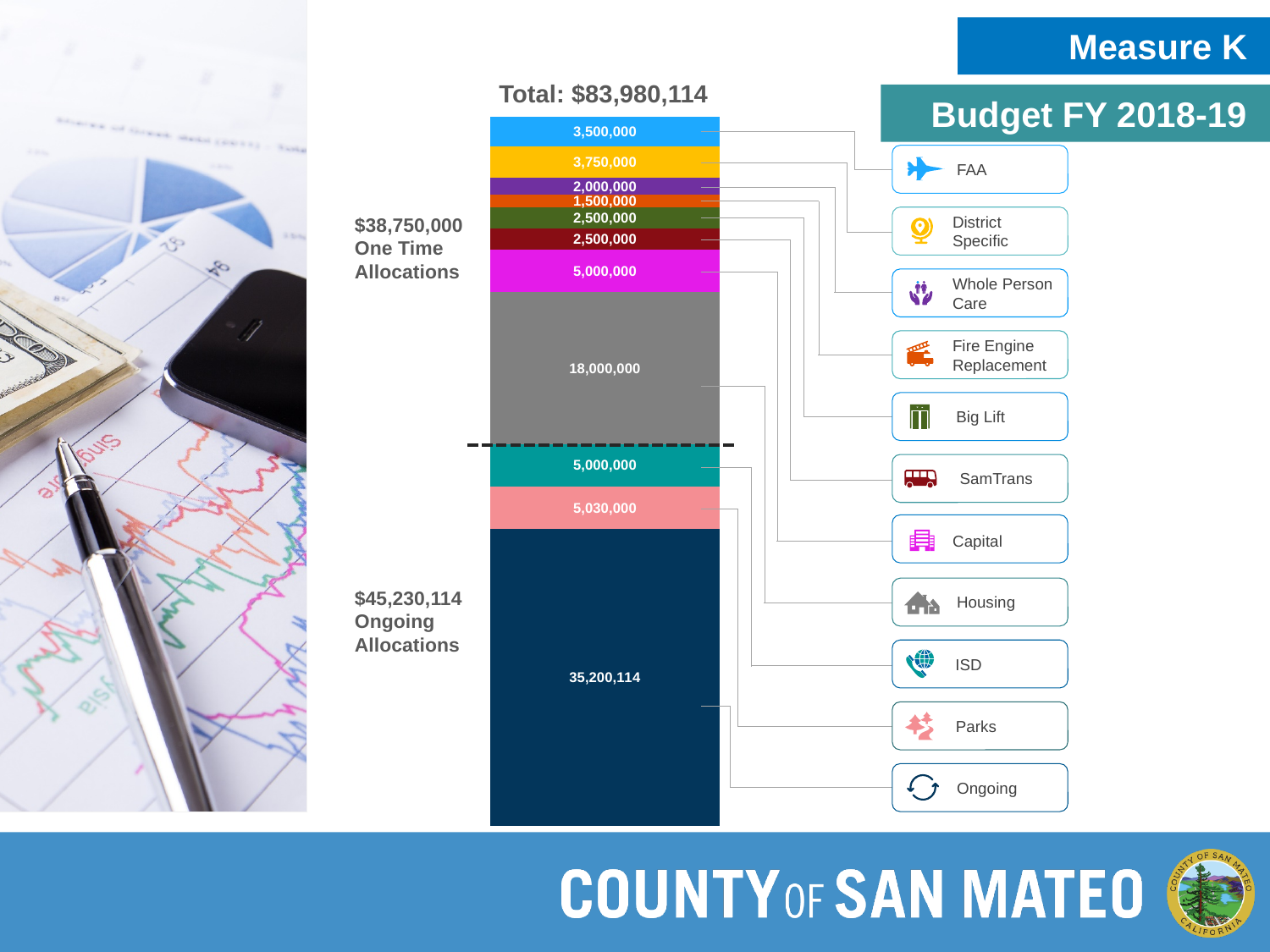
How many segments make up the stacked bar? 11 What kind of chart is shown on the slide? Stacked bar chart What is the difference between the Housing segment and the Capital segment? 13,000,000 What is the total shown above the stacked bar chart? $83,980,114 What is the value of the Parks segment? 5,030,000 What is the value of the Housing segment? 18,000,000 What is the total of the One Time Allocations shown on the slide? $38,750,000 What is the value of the largest segment in the stacked bar? 35,200,114 What is the value of the District Specific segment? 3,750,000 Which is larger, the FAA segment or the District Specific segment? District Specific Which category has the smallest segment in the stacked bar? Fire Engine Replacement What is the total of the Ongoing Allocations shown on the slide? $45,230,114